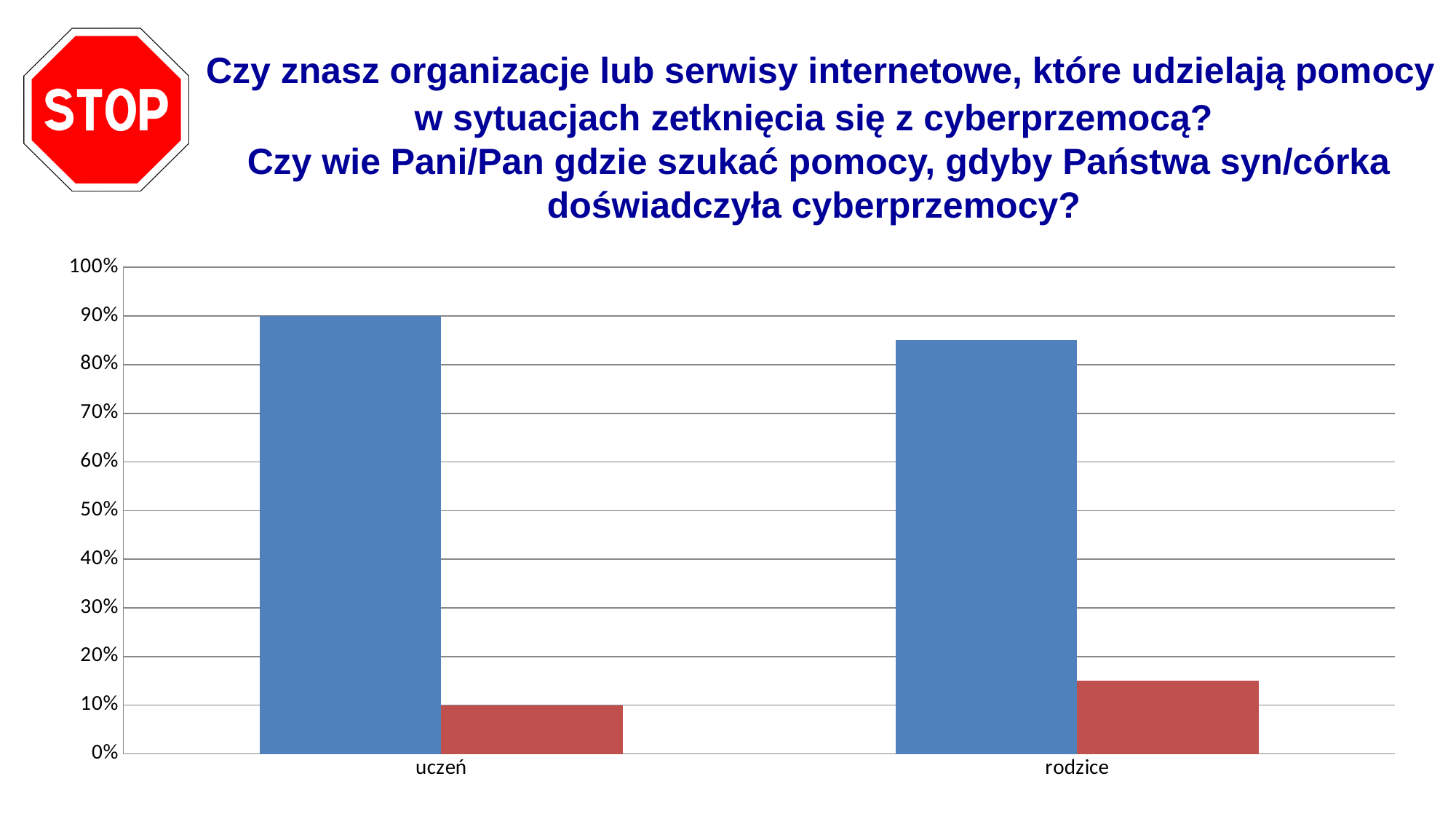
Which category has the higher red bar, uczeń or rodzice? rodzice Is the value of the red bar for rodzice greater or less than 20%? less What is the difference between the blue bar and the red bar for uczeń? 80% Is the value of the red bar for rodzice greater or less than 10%? greater What kind of chart is shown on the slide? bar chart What is the highest value shown on the y axis of the chart? 100% Is the value of the blue bar for rodzice greater or less than 80%? greater What is the value of the red bar for uczeń? 10% What is the value of the blue bar for uczeń? 90% Which category has the higher blue bar, uczeń or rodzice? uczeń How many categories are shown on the x axis of the chart? 2